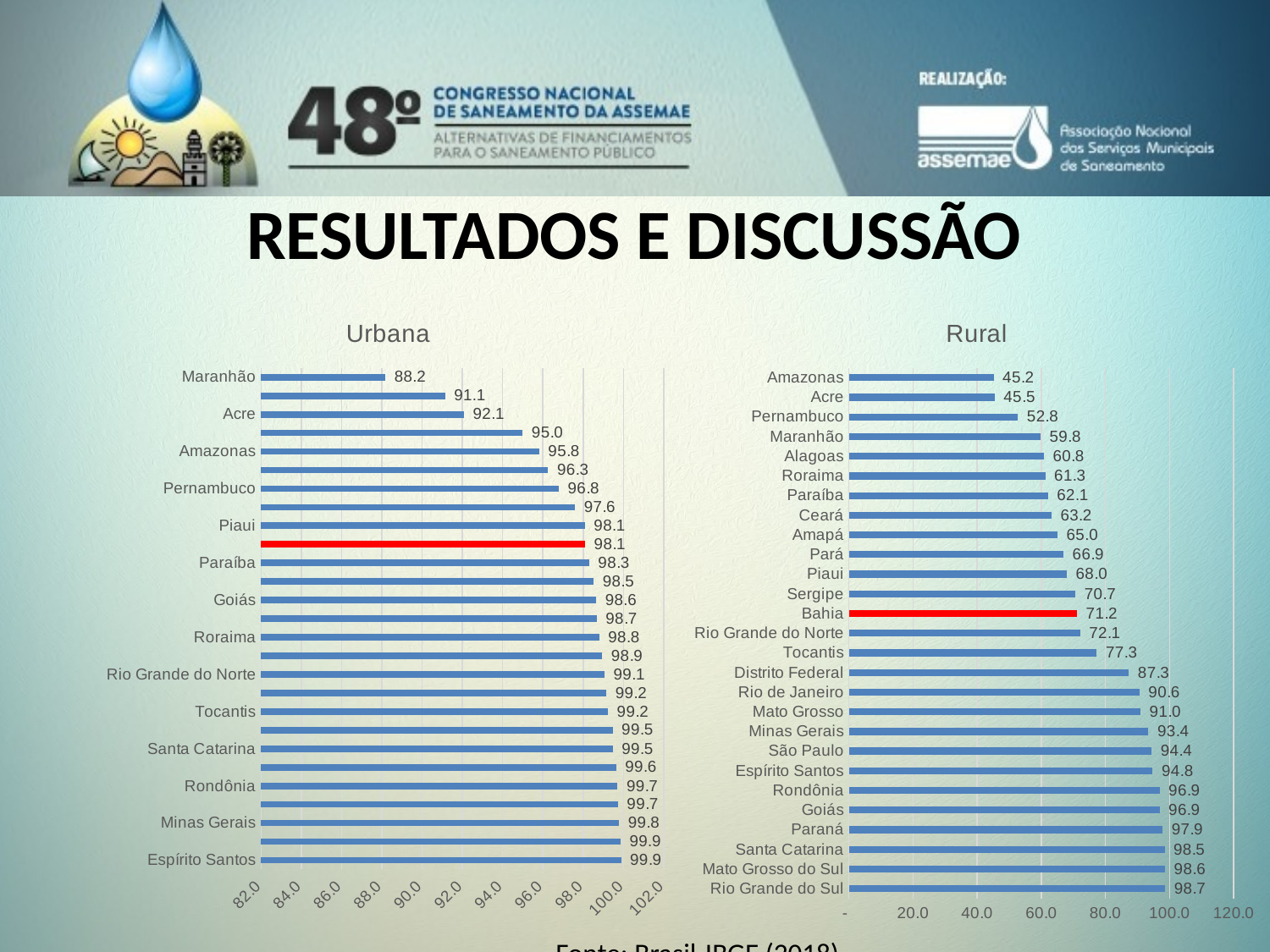
In the Rural chart, what is the value for Bahia? 71.2 In the Urbana chart, what is the value for Acre? 92.1 What type of chart is the Rural chart? Bar chart In the Rural chart, which state has the highest value? Rio Grande do Sul In the Urbana chart, which state has the lowest value? Maranhão In the Urbana chart, what is the value for Maranhão? 88.2 In the Rural chart, which is larger, the value for Pernambuco or the value for Maranhão? Maranhão In the Rural chart, what is the difference between the values for Rio Grande do Sul and Amazonas? 53.5 In the Rural chart, what is the value for Distrito Federal? 87.3 In the Rural chart, which state has the lowest value? Amazonas In the Rural chart, which state's bar is coloured red? Bahia How many states are shown in the Rural chart? 27